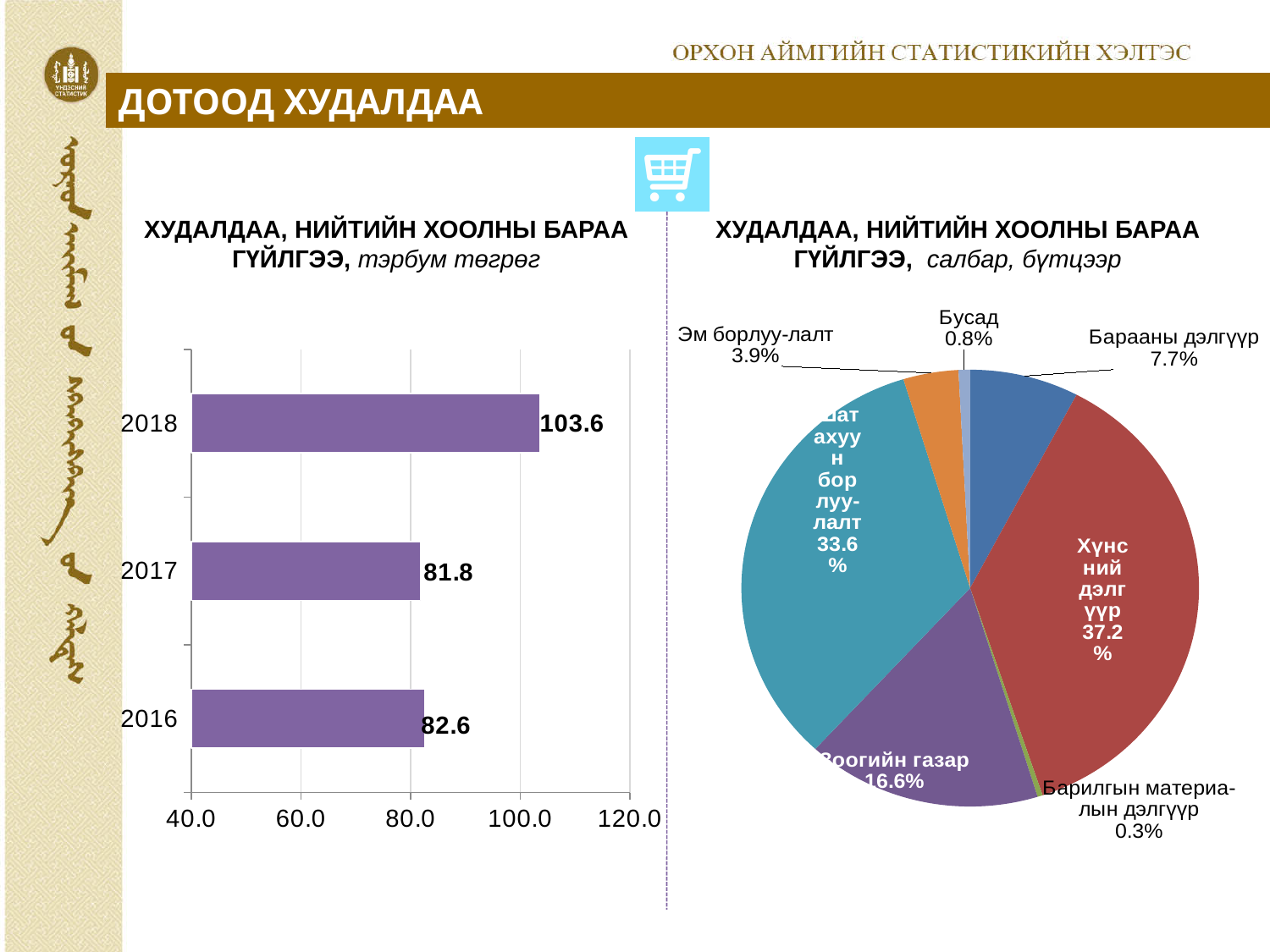
In the left bar chart, what is the value for 2016? 82.6 In the left bar chart, what is the value for 2018? 103.6 In the left bar chart, which year has the highest value? 2018 In the right pie chart, what share does Хүнсний дэлгүүр have? 37.2% In the left bar chart, what is the value for 2017? 81.8 What kind of chart is the left chart? bar chart In the left bar chart, how many years are shown? 3 In the right pie chart, which category has the smallest share? Барилгын материалын дэлгүүр In the right pie chart, what share does Барааны дэлгүүр have? 7.7% In the right pie chart, which is larger: Эм борлуулалт or Бусад? Эм борлуулалт In the right pie chart, what share does Зоогийн газар have? 16.6% In the left bar chart, what is the difference between the 2018 and 2017 values? 21.8